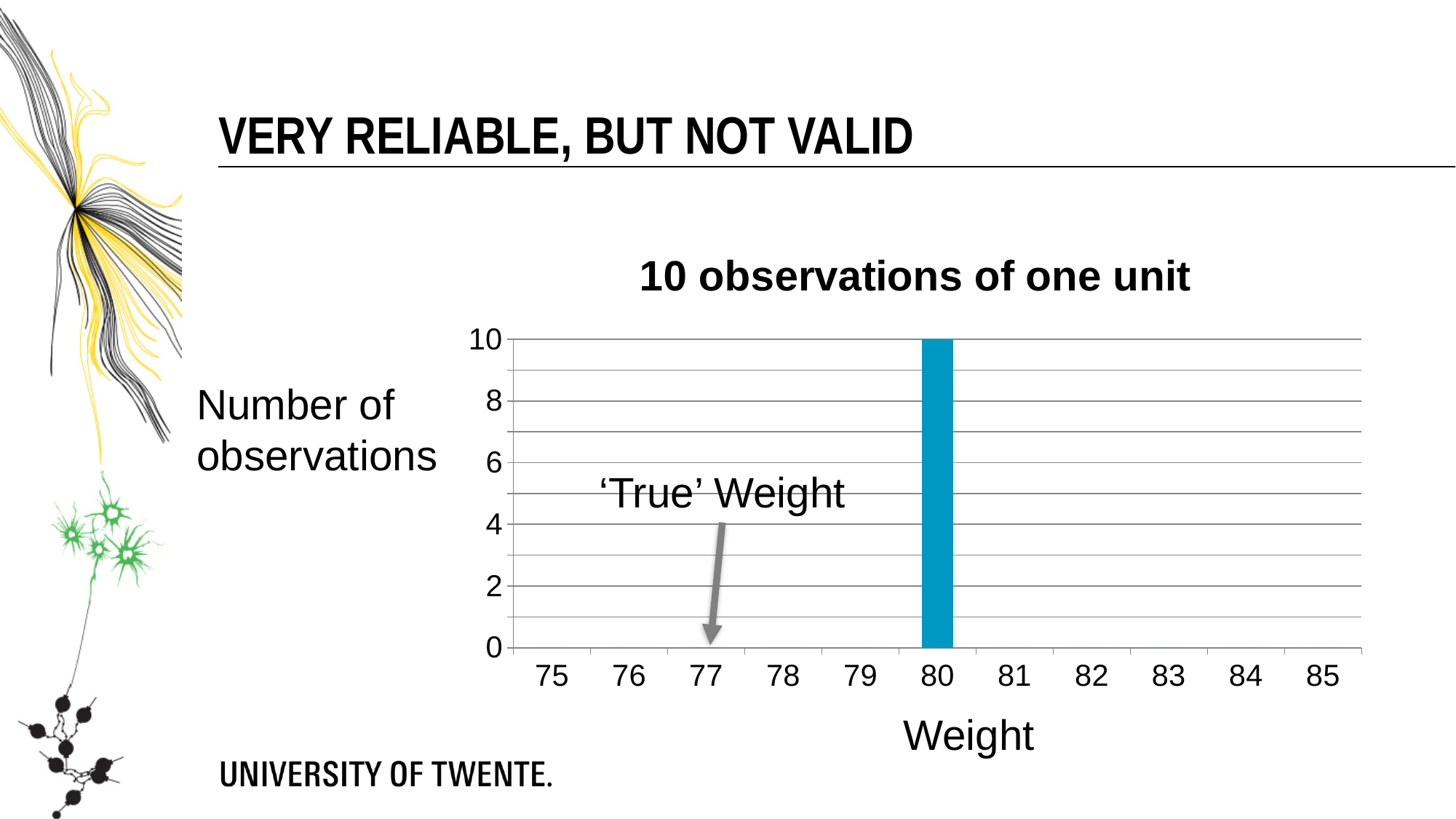
Which has more observations, weight 80 or weight 81? 80 How many weight categories are shown on the x axis? 11 What kind of chart is shown on the slide? bar chart Which weight has the highest number of observations? 80 What is the highest value shown on the y axis? 10 Is the number of observations at weight 77 greater or less than 2? less Is the number of observations at weight 80 greater or less than 8? greater What is the title of the chart? 10 observations of one unit What is the label of the x axis? Weight What is the number of observations at weight 80? 10 What is the number of observations at weight 83? 0